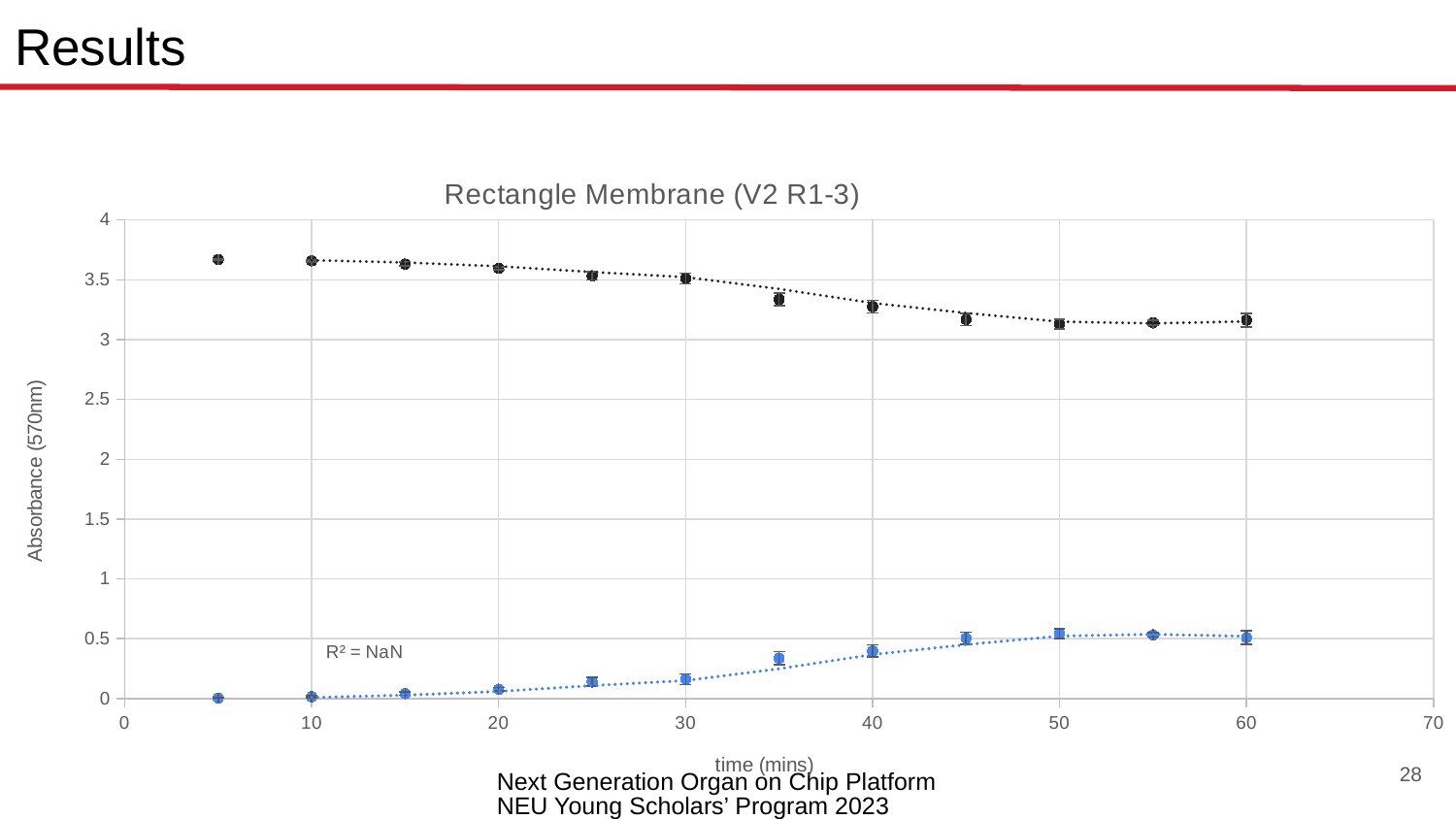
Is the value of the black series at 5 mins greater or less than 3.5? greater Is the value of the blue series at 40 mins greater or less than 0.5? less Which is larger: the blue series value at 20 mins or at 40 mins? 40 mins Is the value of the black series at 50 mins greater or less than 3? greater How many data points does the black series have? 12 What is the title of the chart? Rectangle Membrane (V2 R1-3) How many data series are plotted on the chart? 2 What kind of chart is shown on the slide? scatter chart Does the black series rise or fall as time increases? fall What is the label of the y axis? Absorbance (570nm) Does the blue series rise or fall as time increases? rise